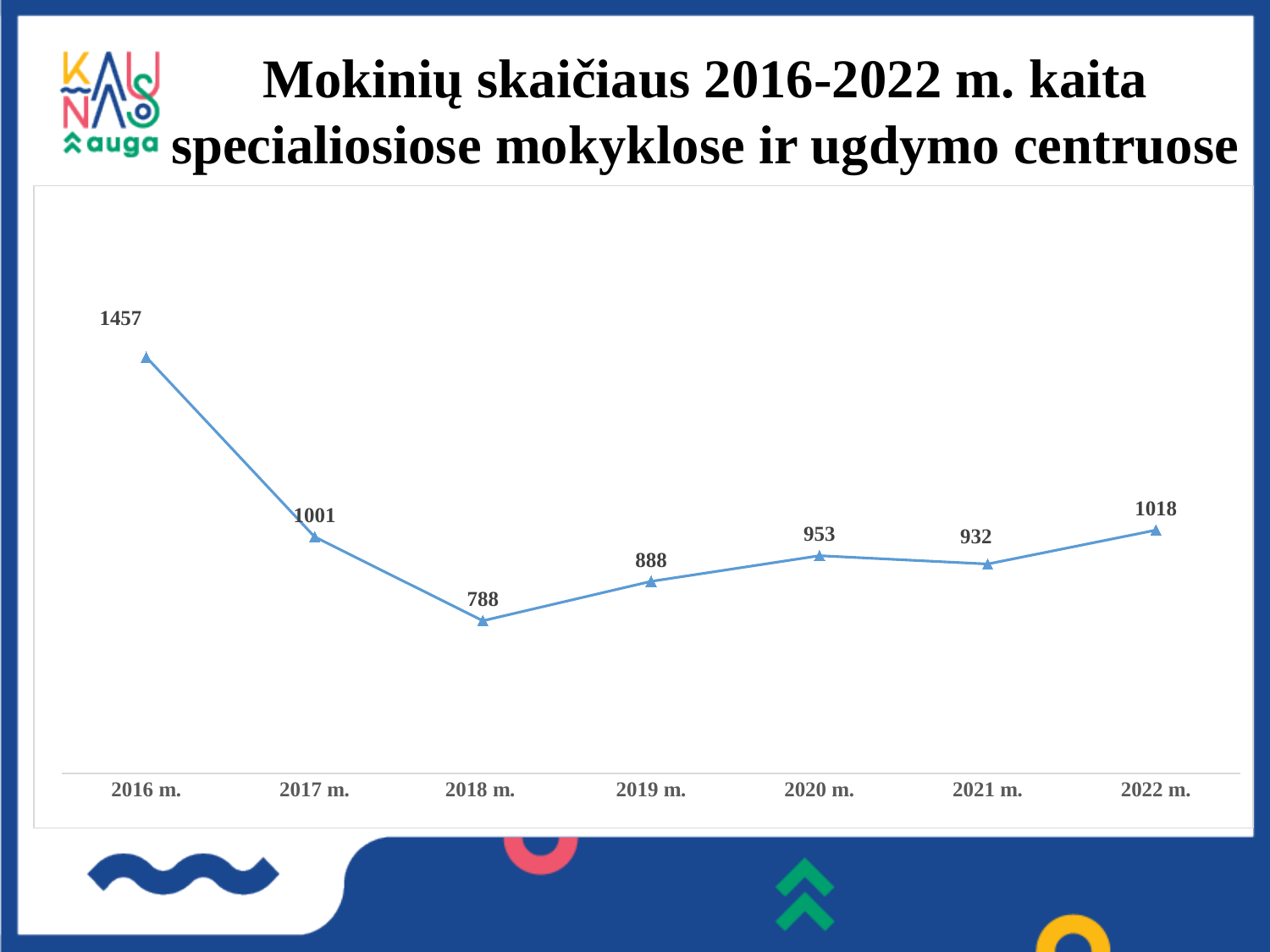
Which year has the lowest value? 2018 m. What is the value for 2022 m.? 1018 What kind of chart is shown on the slide? line chart Which year has the highest value? 2016 m. Which is larger, the value for 2020 m. or the value for 2021 m.? 2020 m. What is the value for 2018 m.? 788 What is the difference between the values for 2022 m. and 2021 m.? 86 What is the title of the chart? Mokinių skaičiaus 2016-2022 m. kaita specialiosiose mokyklose ir ugdymo centruose What is the difference between the values for 2016 m. and 2017 m.? 456 Do the values rise or fall from 2016 m. to 2018 m.? fall How many years are plotted on the chart? 7 What is the value for 2016 m.? 1457